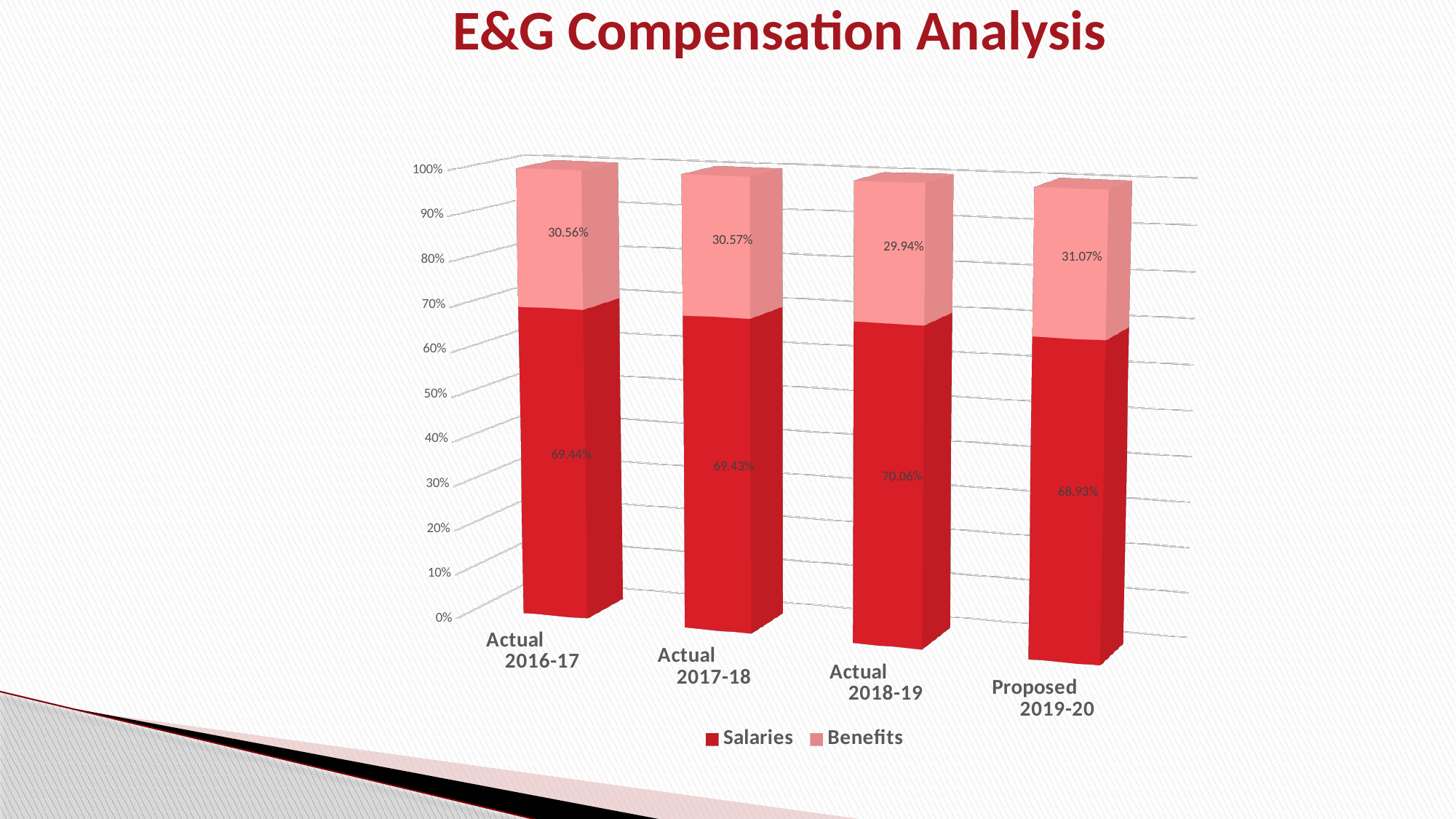
What is the Benefits value for Actual 2018-19? 29.94% Which is larger: the Benefits value for Actual 2017-18 or the Benefits value for Proposed 2019-20? Proposed 2019-20 What is the Benefits value for Proposed 2019-20? 31.07% How many categories are shown on the x axis? 4 How many series does the legend list? 2 What kind of chart is shown on the slide? Stacked bar chart What is the Salaries value for Actual 2016-17? 69.44% What is the Salaries value for Actual 2017-18? 69.43% What is the difference between the Salaries value for Actual 2018-19 and the Salaries value for Proposed 2019-20? 1.13% Which category has the lowest Benefits value? Actual 2018-19 Which category has the highest Salaries value? Actual 2018-19 What is the title of the chart? E&G Compensation Analysis